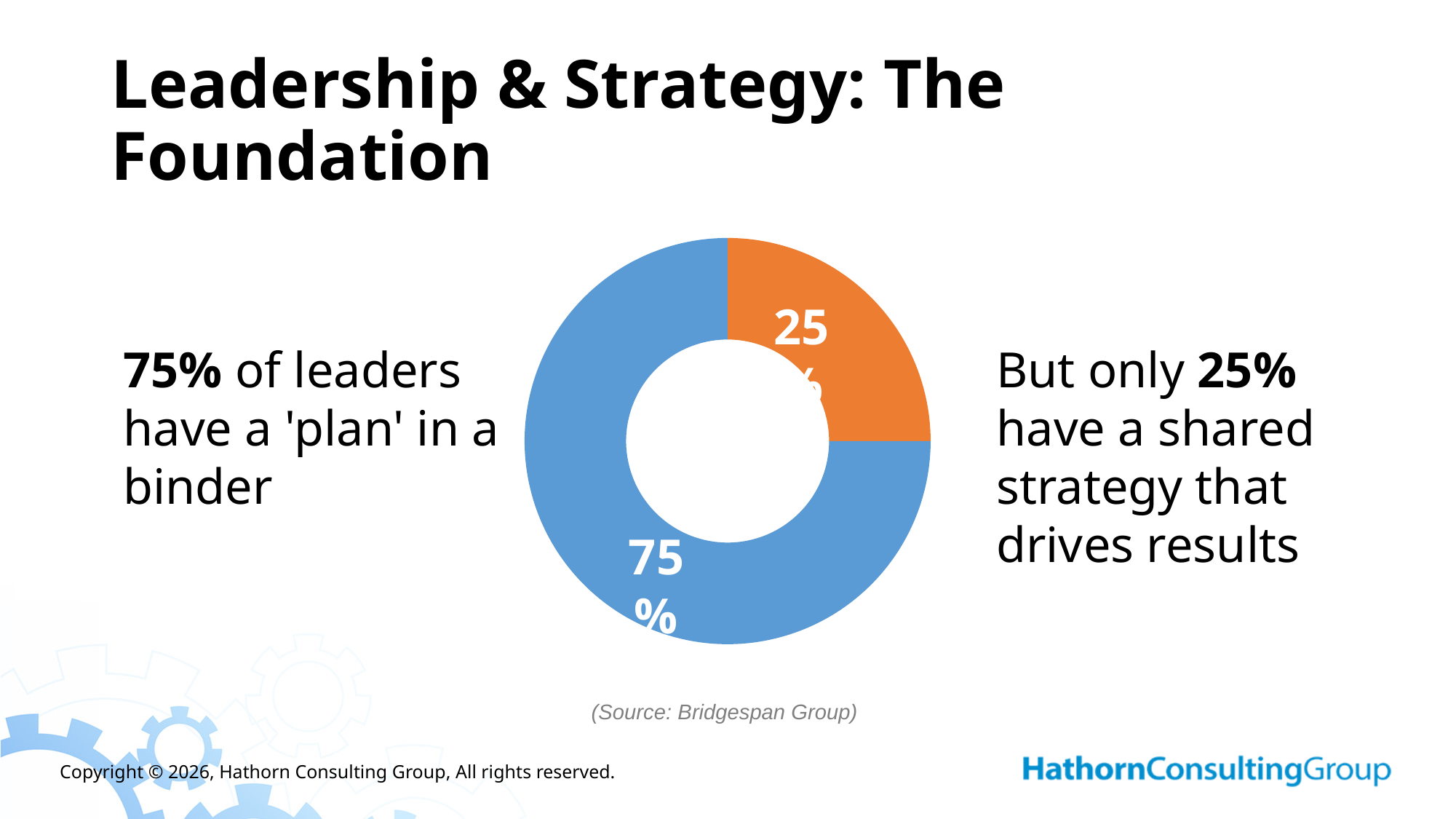
How many slices does the donut chart have? 2 Which slice of the donut chart is the smallest? The orange slice (25%) Which slice of the donut chart is the largest? The blue slice (75%) What kind of chart is shown on the slide? Pie chart (donut) What share of the donut chart does the orange slice represent? 25% Is the blue slice or the orange slice larger? The blue slice What is the difference between the two values shown on the donut chart? 50 percentage points According to the slide, what percentage of leaders have a shared strategy that drives results? 25% What source is cited below the chart? Bridgespan Group What colour is the slice representing 75%? Blue What value is labelled on the blue slice of the donut chart? 75% What value is labelled on the orange slice of the donut chart? 25%